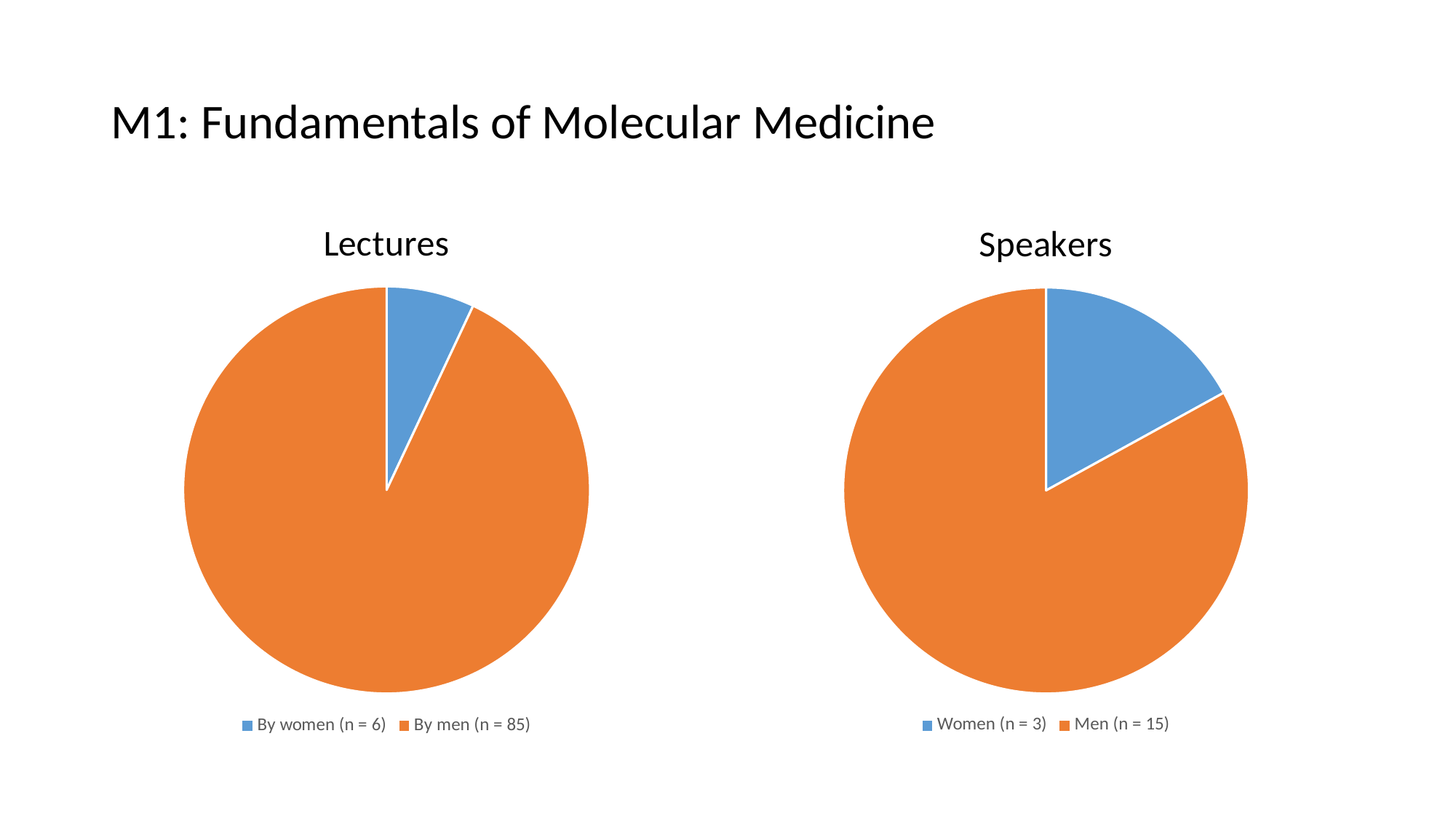
What type of chart is used for the Speakers chart? Pie chart In the Lectures pie chart, what is the total number of lectures across both categories? 91 In the Lectures pie chart, what is the difference between the number of lectures by men and by women? 79 In the Speakers pie chart, how many speakers were women? 3 In the Lectures pie chart, what colour is the slice for lectures by women? Blue In the Speakers pie chart, how many speakers were men? 15 In the Speakers pie chart, what is the difference between the number of men and women speakers? 12 In the Lectures pie chart, which category has the largest slice? By men (n = 85) In the Speakers pie chart, what is the total number of speakers across both categories? 18 In the Lectures pie chart, how many lectures were given by women? 6 In the Speakers pie chart, which category has the smallest slice? Women (n = 3) In the Lectures pie chart, how many lectures were given by men? 85